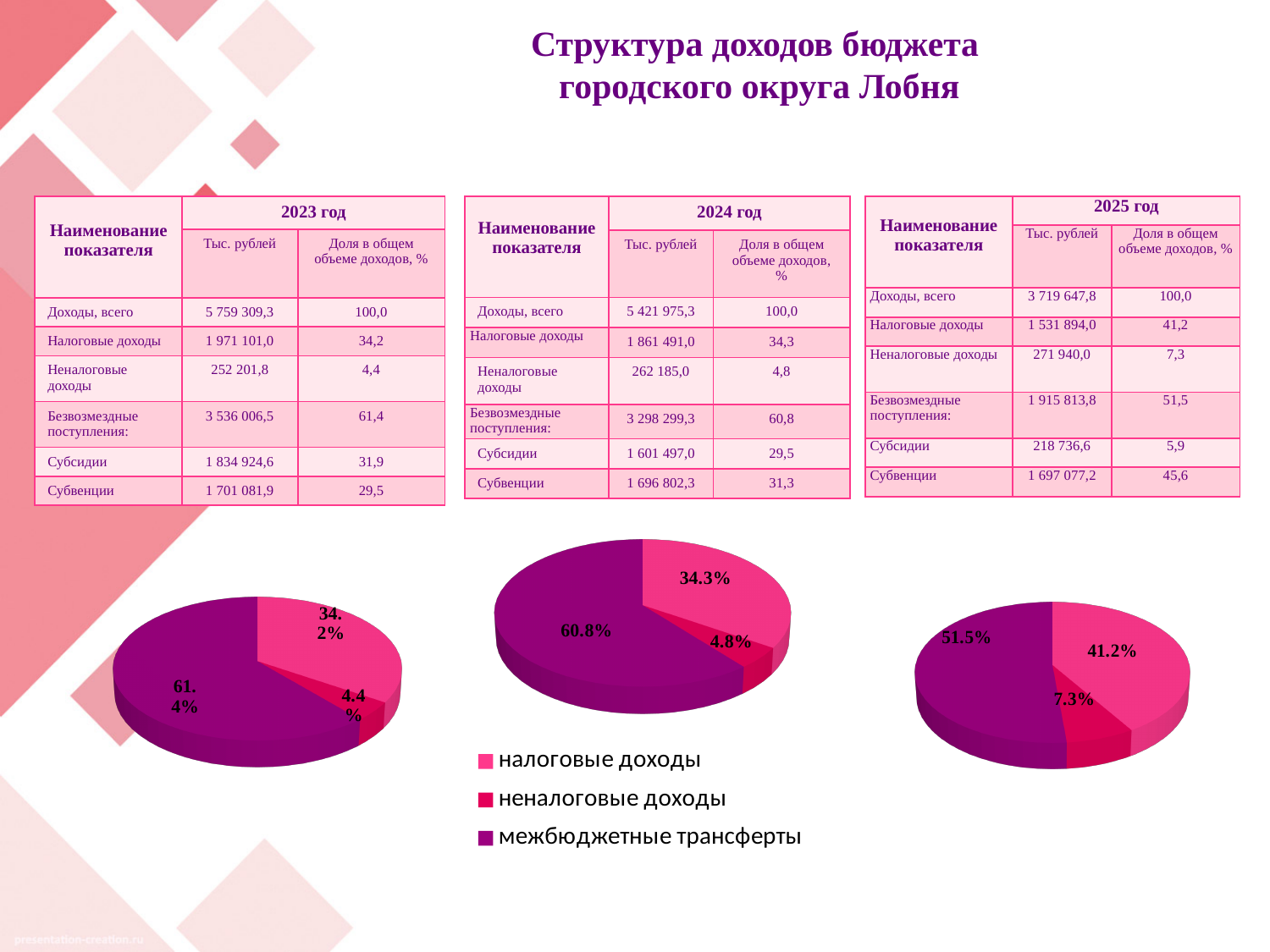
How many slices does the right-hand pie chart have? 3 In the right-hand pie chart, what share is labelled on the slice for налоговые доходы? 41.2% In the left-hand pie chart, which is larger: the slice for налоговые доходы or the slice for неналоговые доходы? налоговые доходы In the right-hand pie chart, which category has the smallest slice? неналоговые доходы In the middle pie chart, what share is labelled on the slice for неналоговые доходы? 4.8% How many entries does the legend below the pie charts list? 3 In the right-hand pie chart, what is the difference between the shares for межбюджетные трансферты (51.5%) and налоговые доходы (41.2%)? 10.3% What kind of chart is the left-hand chart at the bottom of the slide? pie chart In the left-hand pie chart, what share is labelled on the largest slice (межбюджетные трансферты)? 61.4% In the middle pie chart, what share is labelled on the slice for межбюджетные трансферты? 60.8% In the left-hand pie chart, what share is labelled on the slice for налоговые доходы? 34.2% In the middle pie chart, which category has the largest slice? межбюджетные трансферты